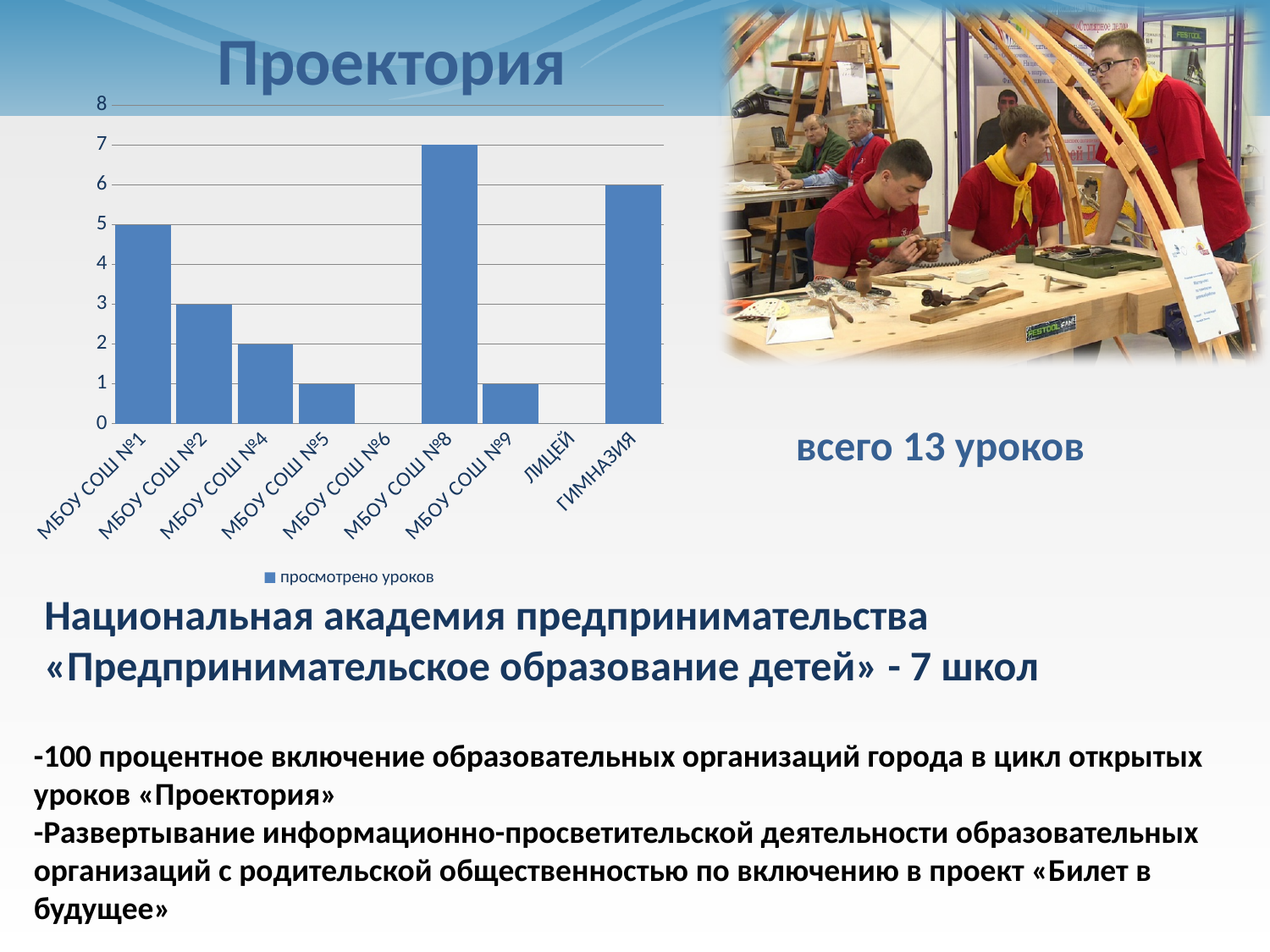
Which is larger, the value for МБОУ СОШ №1 or the value for ГИМНАЗИЯ? ГИМНАЗИЯ Is the value for МБОУ СОШ №2 greater or less than 4? less How many series does the chart legend list? 1 What is the value for ГИМНАЗИЯ? 6 What is the value for МБОУ СОШ №4? 2 What is the value for МБОУ СОШ №1? 5 What is the value for МБОУ СОШ №8? 7 What is the difference between the values for МБОУ СОШ №8 and МБОУ СОШ №2? 4 How many categories are shown on the x axis of the chart? 9 Which category has the highest value? МБОУ СОШ №8 What is the legend entry of the chart? просмотрено уроков What kind of chart is shown on the slide? bar chart